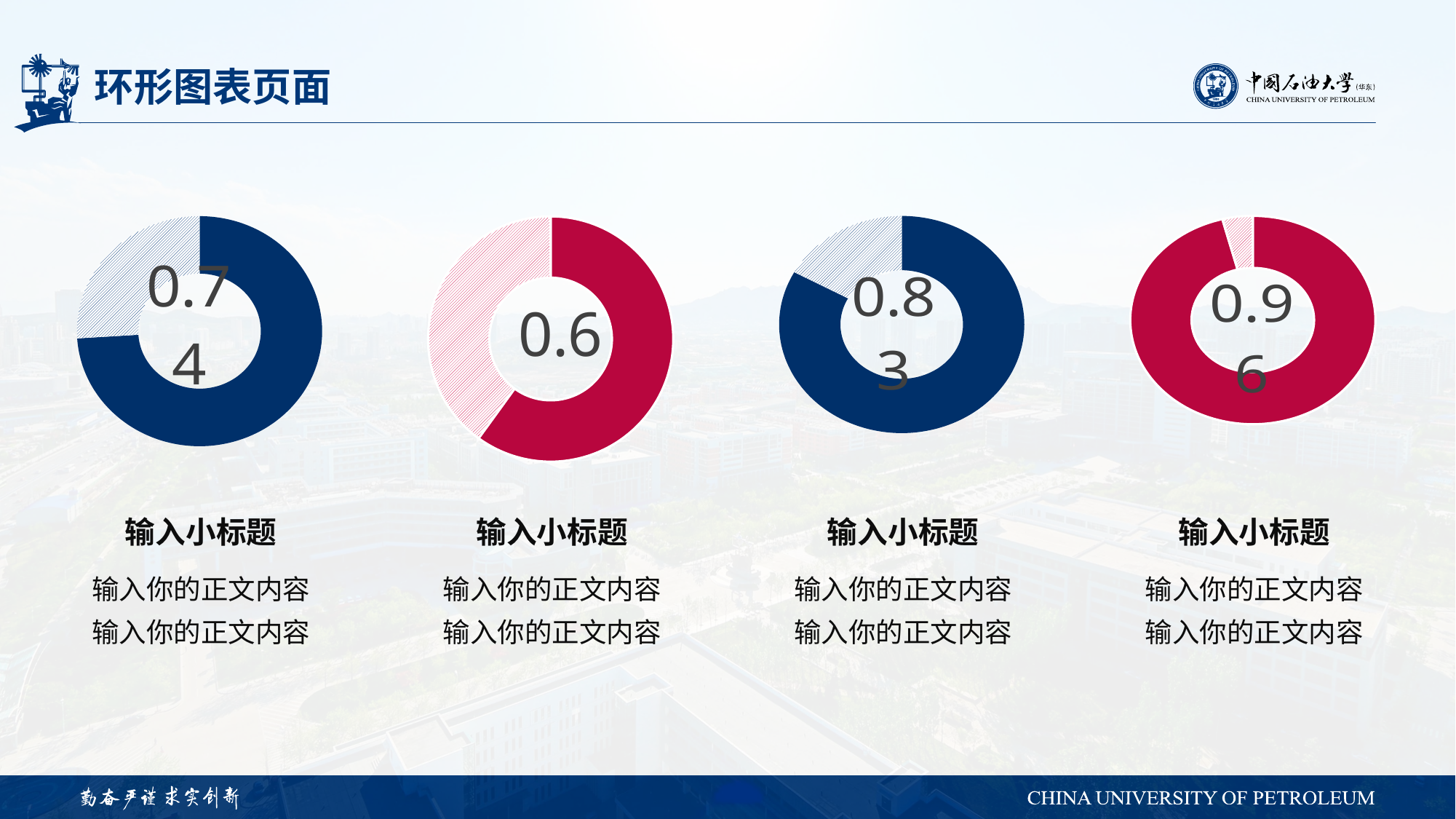
What value is shown in the centre of the rightmost donut chart? 0.96 Which is larger, the value of the leftmost donut chart or the third donut chart from the left? The third chart (0.83) What kind of chart is used on this slide? Donut chart What value is shown in the centre of the third donut chart from the left? 0.83 What is the difference between the value of the rightmost donut chart and the leftmost donut chart? 0.22 What value is shown in the centre of the second donut chart from the left? 0.6 Which of the four donut charts shows the lowest value? The second chart from the left (0.6) What value is shown in the centre of the leftmost donut chart? 0.74 Which of the four donut charts shows the highest value? The rightmost chart (0.96) What colour is the filled portion of the second donut chart from the left? Red How many donut charts are on the slide? 4 What is the difference between the value of the third donut chart and the second donut chart? 0.23